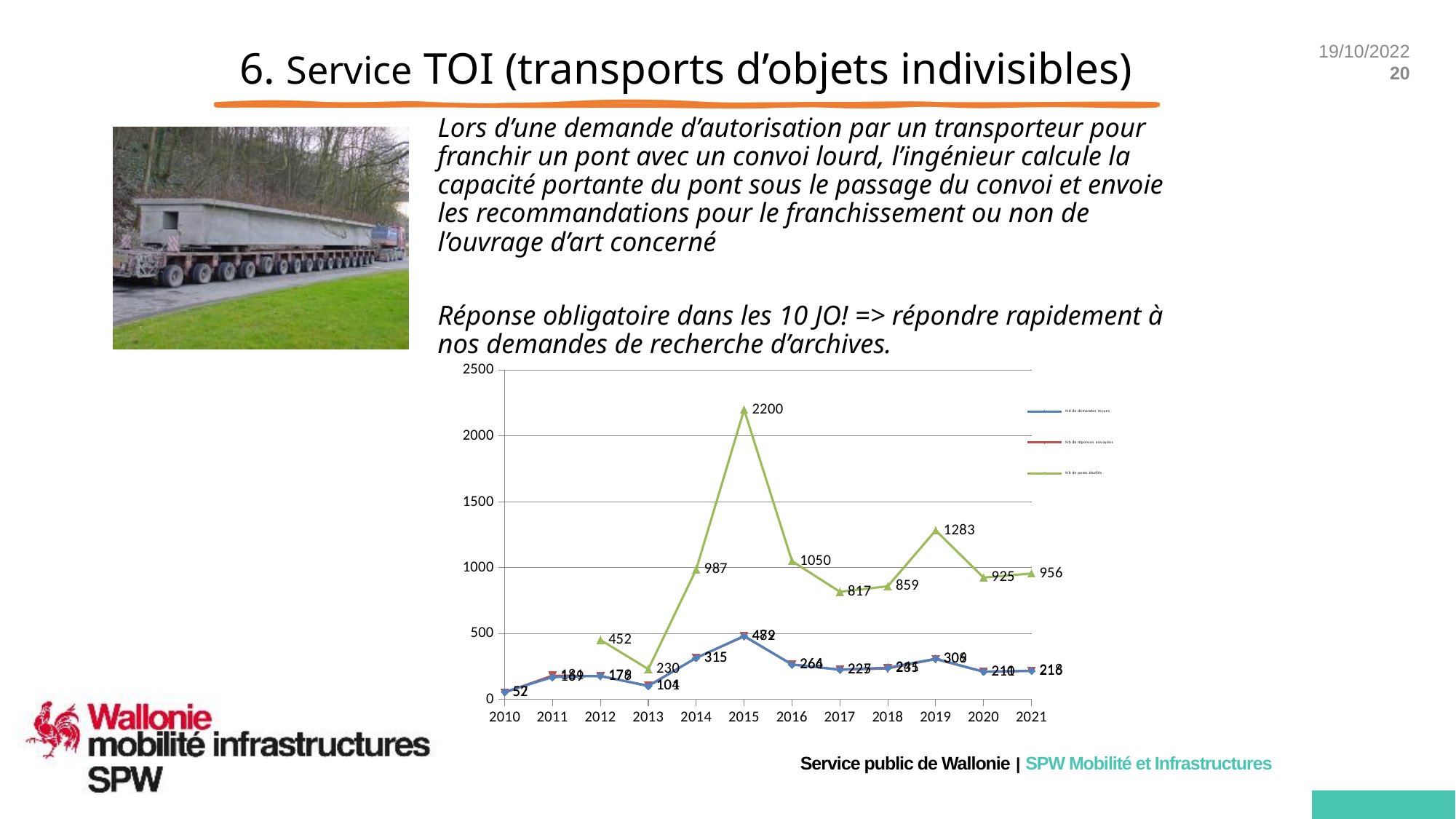
Which year has the larger value on the green line, 2016 or 2019? 2019 What is the difference between the green line's values in 2015 and 2019? 917 Does the green line rise or fall from 2015 to 2017? fall How many years are shown on the x axis of the chart? 12 In which year does the green line reach its highest value? 2015 What kind of chart is shown on the slide? line chart Is the value of the blue line in 2015 greater or less than 500? less What is the value of the green line in 2013? 230 In which year does the green line have its lowest value? 2013 What is the value of the green line in 2019? 1283 How many series does the chart's legend list? 3 What is the value of the green line in 2015? 2200